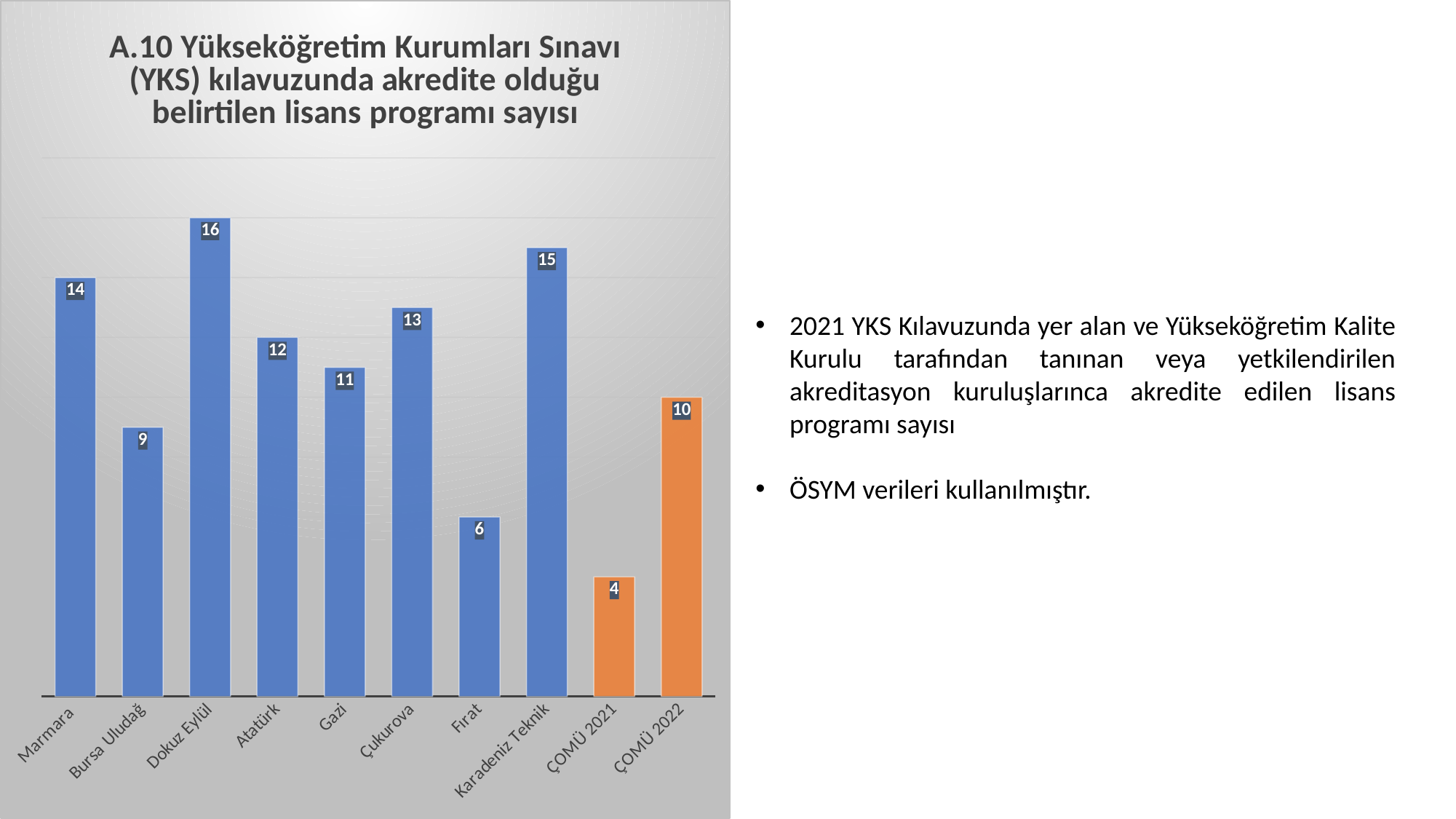
What kind of chart is shown on the slide? Bar chart What is the value for ÇOMÜ 2021? 4 What is the difference between the values for ÇOMÜ 2022 and ÇOMÜ 2021? 6 Which is larger, the value for Çukurova or the value for Atatürk? Çukurova What is the value for Karadeniz Teknik? 15 Which category has the lowest value? ÇOMÜ 2021 How many categories are shown on the x axis? 10 Which is larger, the value for Fırat or the value for Gazi? Gazi What is the value for Dokuz Eylül? 16 What colour are the bars for ÇOMÜ 2021 and ÇOMÜ 2022? Orange What is the difference between the values for Marmara and Bursa Uludağ? 5 Which category has the highest value? Dokuz Eylül